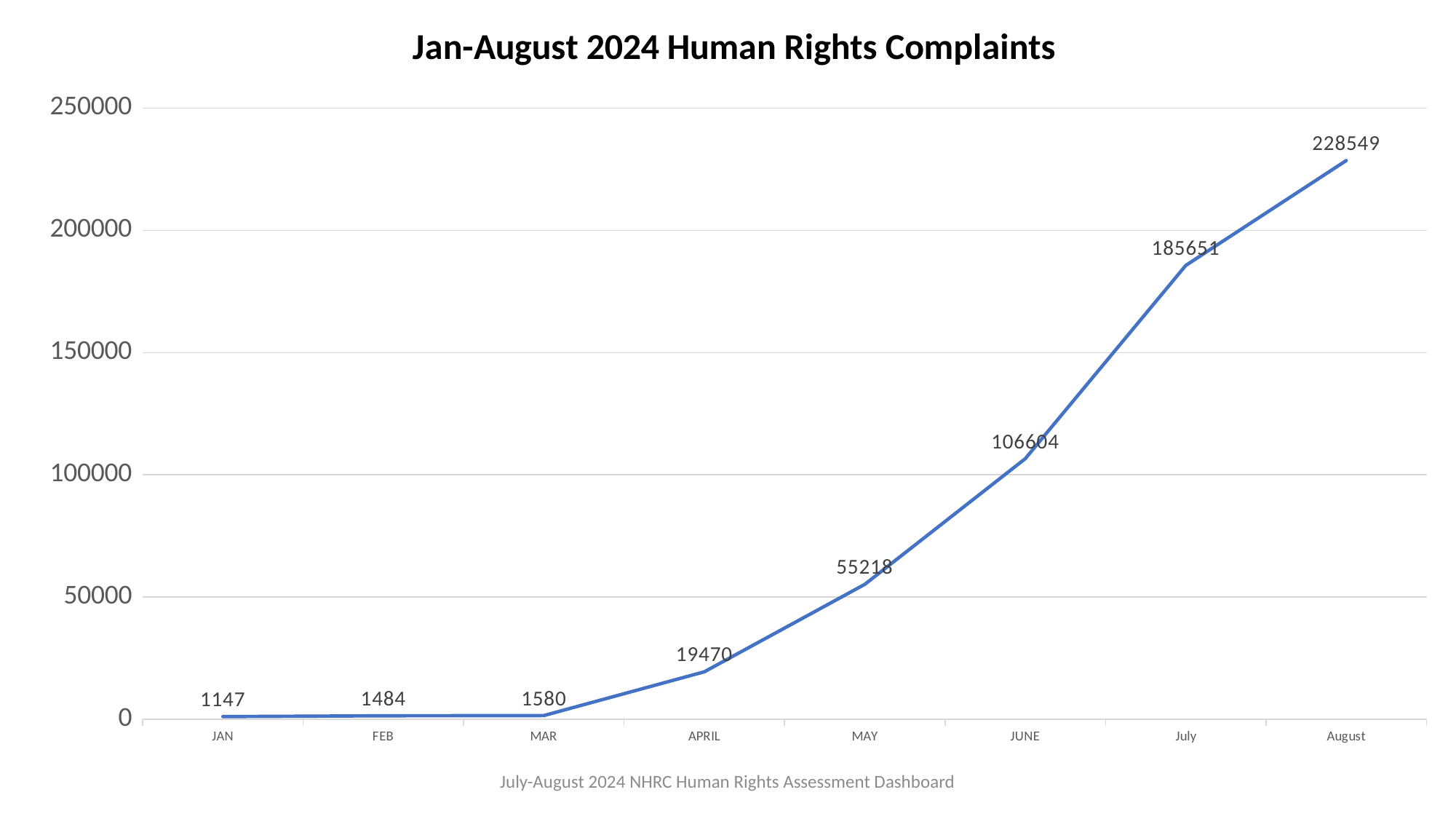
Which month has the highest value? August What is the value for JAN? 1147 How many months are plotted on the chart? 8 What is the value for August? 228549 What is the value for APRIL? 19470 What is the value for JUNE? 106604 What is the difference between the values for August and July? 42898 What is the difference between the values for MAY and APRIL? 35748 Which month has the lowest value? JAN What kind of chart is shown? line chart Is the value for July greater or less than 150000? greater Which is larger, the value for MAY or the value for JUNE? JUNE